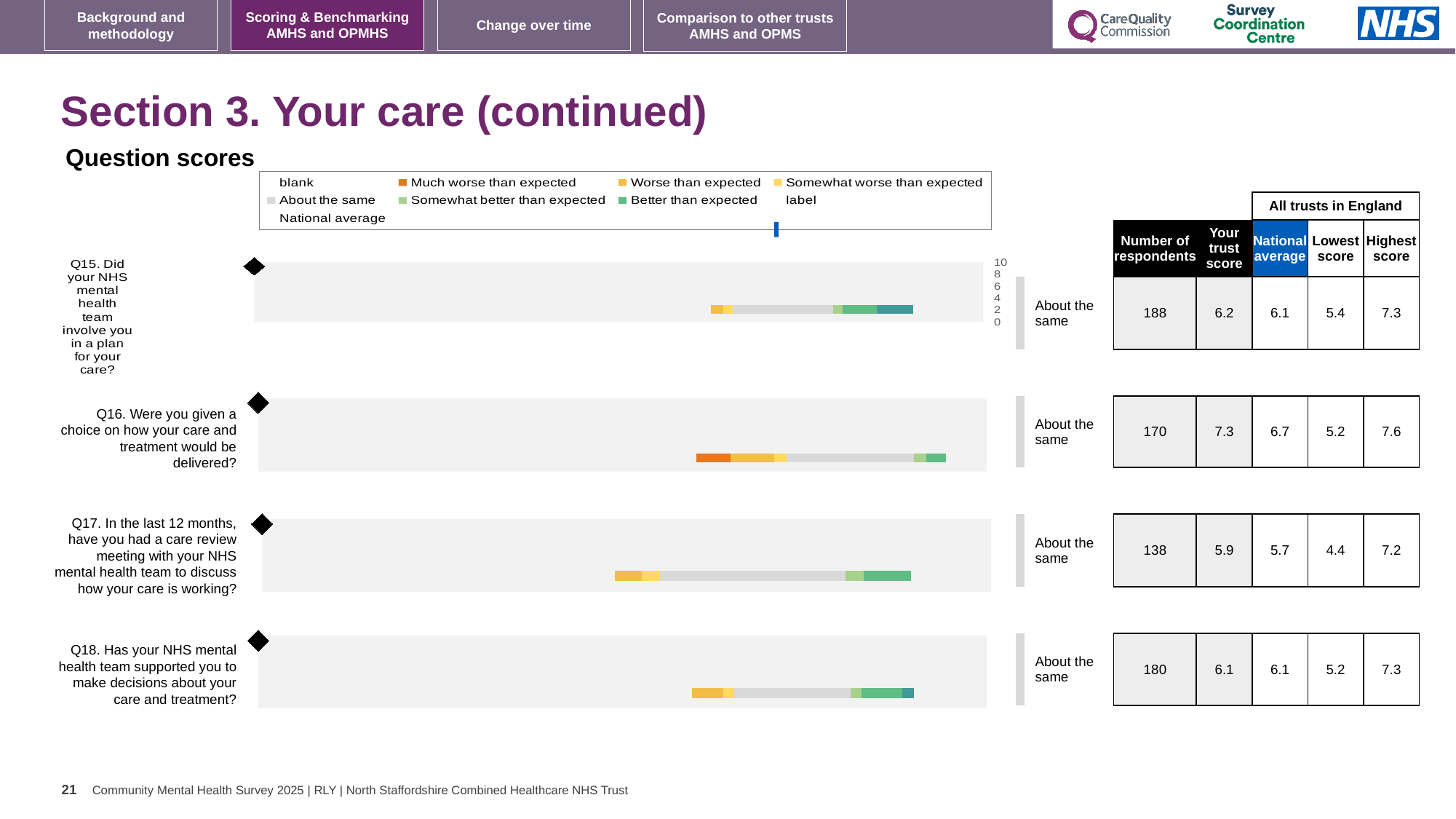
How many entries does the legend above the charts list? 9 Which question has the lowest number of respondents in the table? Q17 What kind of chart is used to show the question scores for Q15 to Q18? Bar chart In the table beside the charts, what is the 'Your trust score' value for Q17? 5.9 What colour does the legend use for 'Much worse than expected'? Orange What benchmark label is shown to the right of the Q18 chart? About the same How many question charts (Q15 to Q18) are shown on the slide? 4 For Q16, what is the difference between 'Your trust score' and the national average? 0.6 Which question has the highest 'Your trust score' in the table? Q16 In the table beside the charts, what is the number of respondents for Q16? 170 In the table beside the charts, what is the highest score across all trusts in England for Q18? 7.3 For Q15, which is larger: 'Your trust score' or the national average? Your trust score